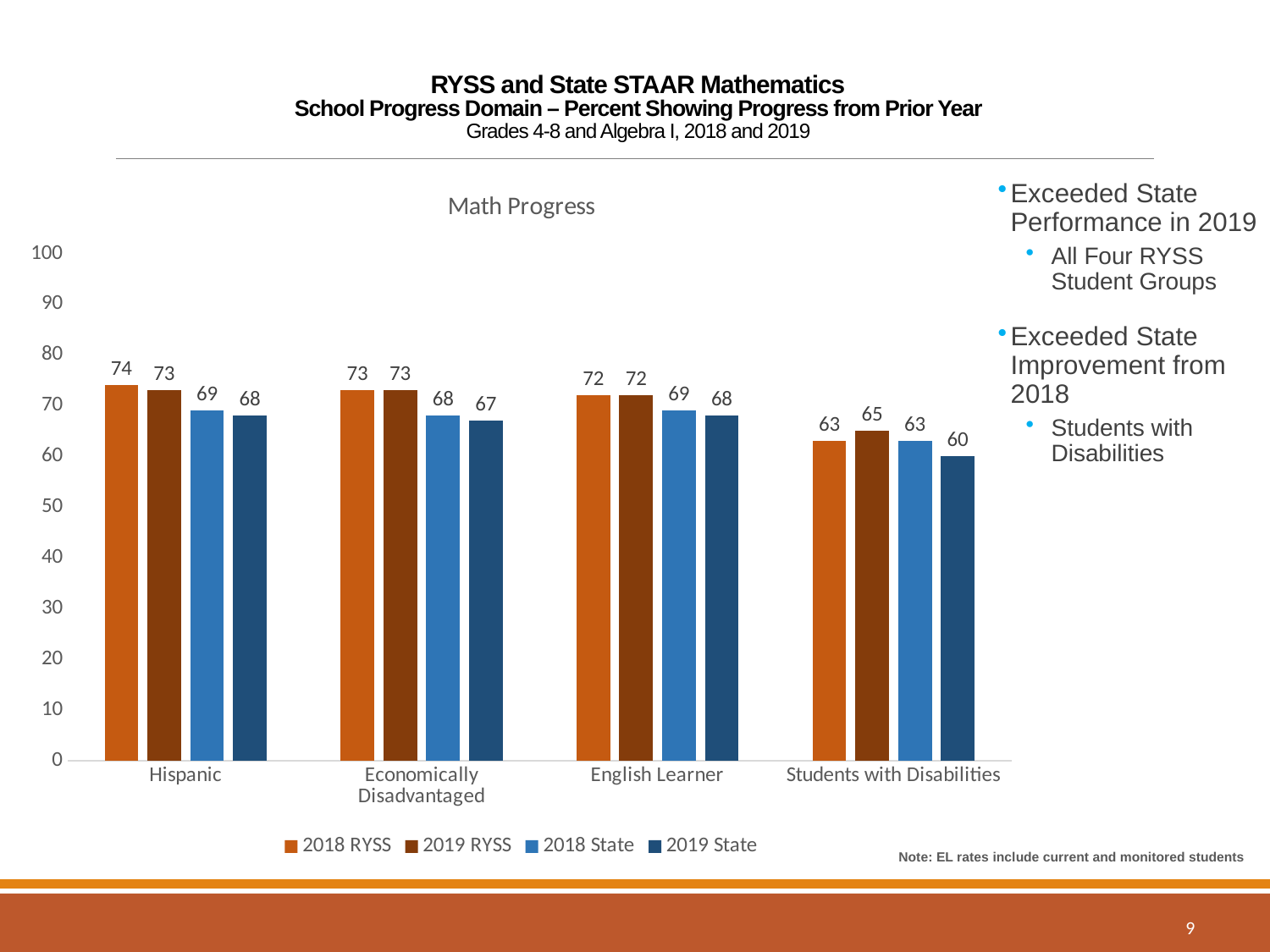
What kind of chart is shown? Bar chart Which category has the lowest 2019 State value? Students with Disabilities What is the 2018 State value for Hispanic? 69 Which is larger for English Learner: the 2019 RYSS value or the 2019 State value? 2019 RYSS What is the 2019 RYSS value for Students with Disabilities? 65 What is the 2019 State value for Economically Disadvantaged? 67 Which category has the highest 2018 RYSS value? Hispanic What is the title of the chart? Math Progress What is the difference between the 2018 RYSS and 2019 RYSS values for Hispanic? 1 How many categories are shown on the x axis? 4 How many series does the legend list? 4 What is the difference between the 2019 RYSS and 2019 State values for Students with Disabilities? 5